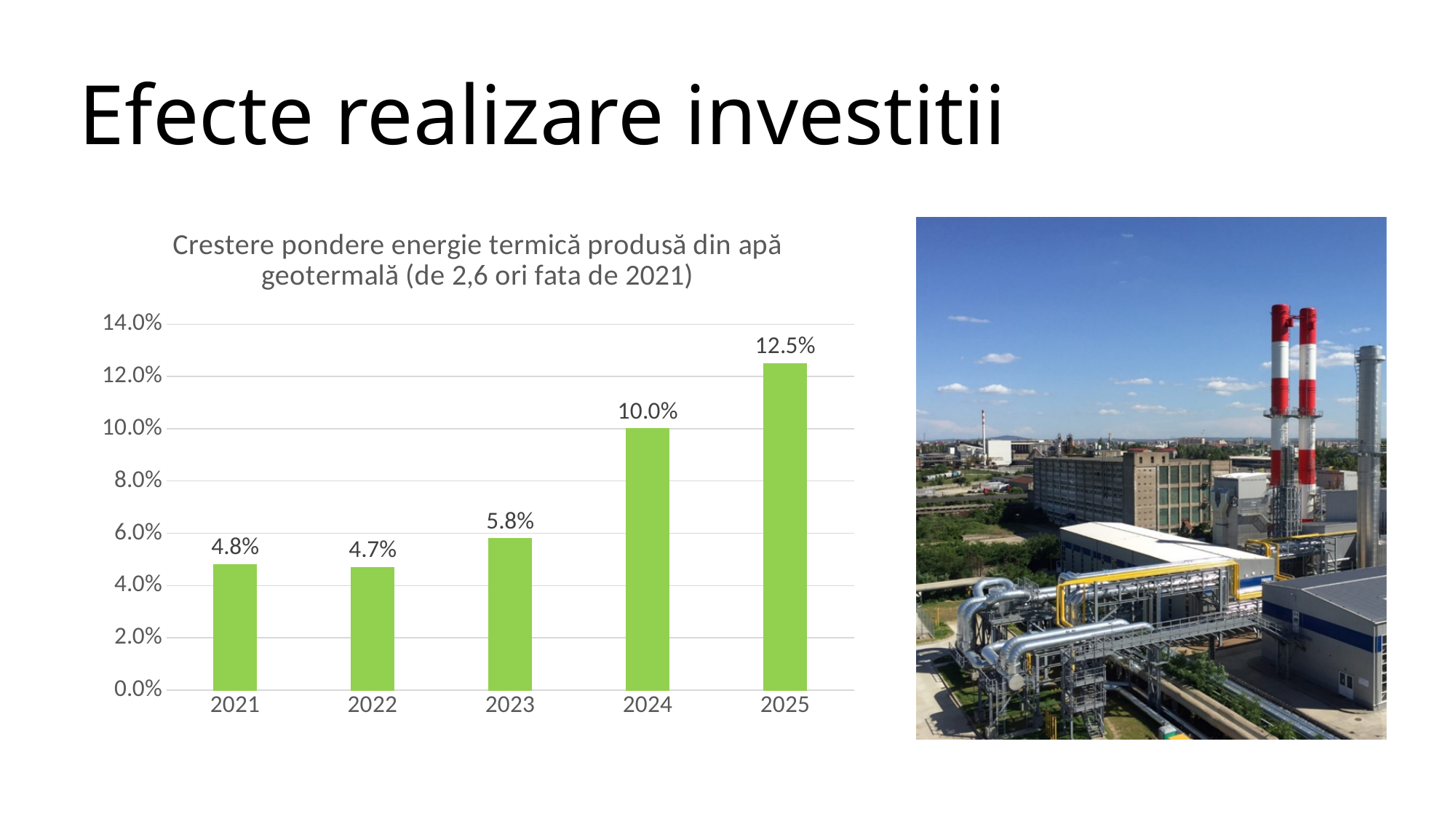
How many years are shown on the x axis? 5 Which year has the lowest value? 2022 What kind of chart is shown on the slide? bar chart Which year has the highest value? 2025 What is the difference between the values for 2025 and 2021? 7.7% What is the difference between the values for 2024 and 2023? 4.2% What is the value for 2024? 10.0% What is the value for 2021? 4.8% What is the title of the chart? Crestere pondere energie termică produsă din apă geotermală (de 2,6 ori fata de 2021) Is the value for 2025 greater or less than 12.0%? greater What is the value for 2023? 5.8% Which is larger, the value for 2023 or the value for 2022? 2023